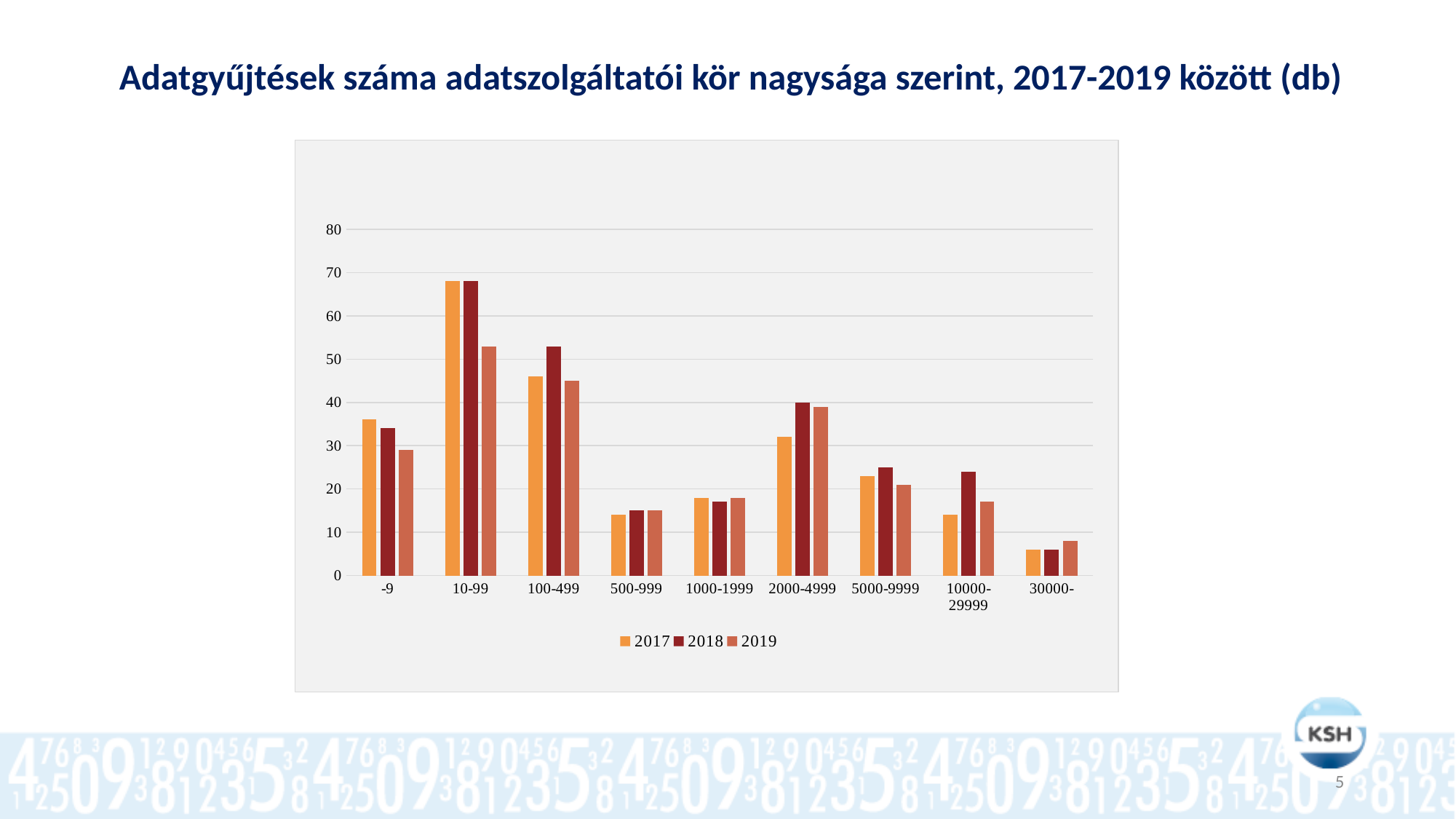
What kind of chart is shown on the slide? bar chart Which category has the lowest value for the 2018 series? 30000- In the 10000-29999 category, which is larger: the 2017 value or the 2018 value? 2018 How many categories are shown on the x axis? 9 Is the 2017 value for the 500-999 category greater or less than 20? less Is the 2019 value for the 30000- category greater or less than 10? less How many series does the legend list? 3 Which category has the lowest value for the 2017 series? 30000- In the -9 category, which is larger: the 2017 value or the 2019 value? 2017 Is the 2017 value for the -9 category greater or less than 30? greater What is the title of the chart on the slide? Adatgyűjtések száma adatszolgáltatói kör nagysága szerint, 2017-2019 között (db) Which category has the highest value for the 2019 series? 10-99